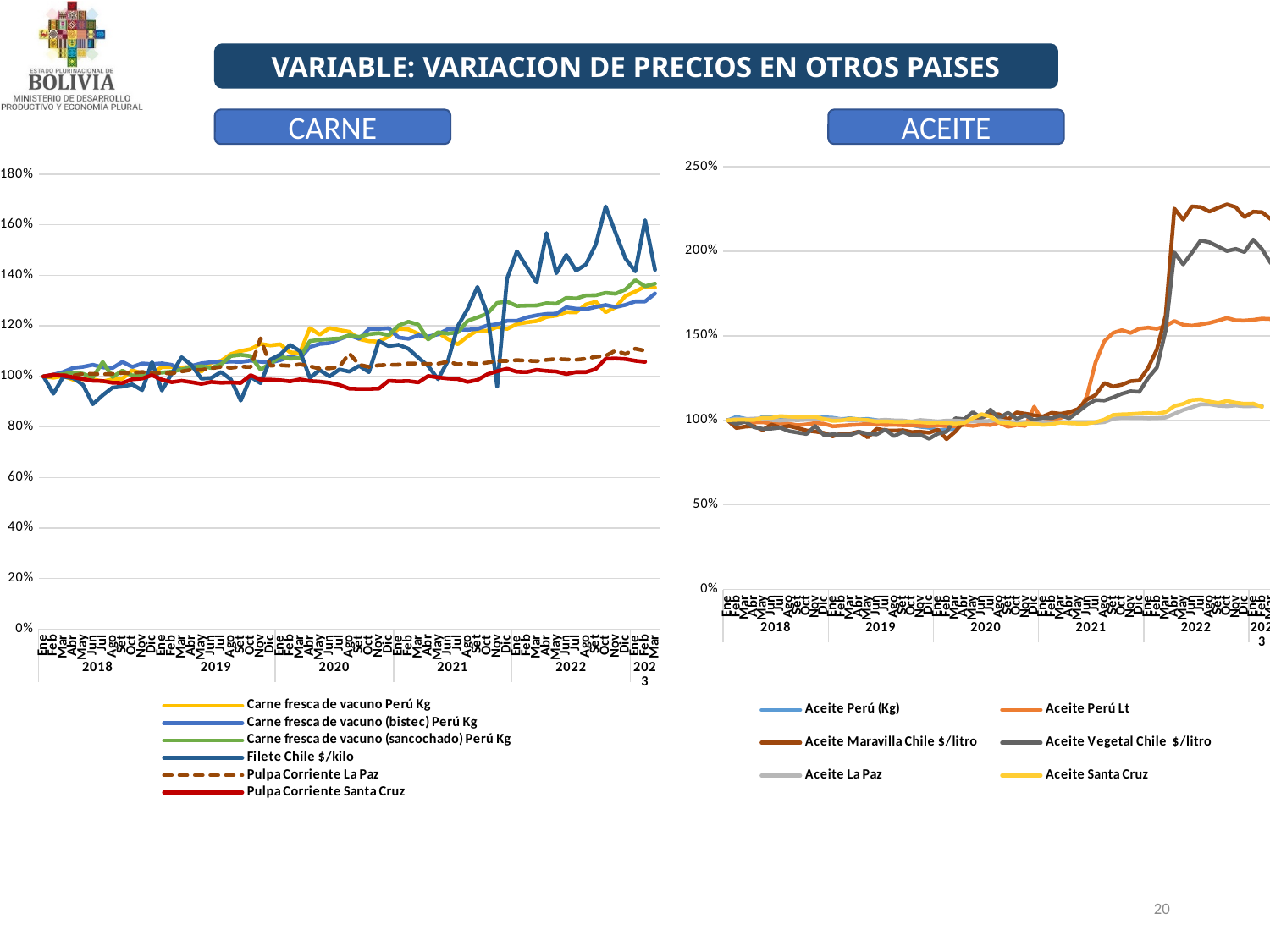
In the ACEITE chart, is the value for Aceite La Paz at the end of the period greater or less than 150%? less What kind of chart is the ACEITE chart? line chart In the ACEITE chart, which series reaches the highest value over the whole period? Aceite Maravilla Chile $/litro In the ACEITE chart, does the Aceite Maravilla Chile $/litro series generally rise or fall from 2018 to 2023? rise In the CARNE chart, at the end of the period, which is higher: Filete Chile $/kilo or Pulpa Corriente Santa Cruz? Filete Chile $/kilo What kind of chart is the CARNE chart? line chart In the CARNE chart, which series reaches the highest value over the whole period? Filete Chile $/kilo In the CARNE chart, is the peak value for Filete Chile $/kilo greater or less than 150%? greater How many series does the legend of the CARNE chart list? 6 In the ACEITE chart, is the peak value for Aceite Maravilla Chile $/litro greater or less than 200%? greater How many series does the legend of the ACEITE chart list? 6 In the ACEITE chart, at the end of the period, which is higher: Aceite Maravilla Chile $/litro or Aceite Vegetal Chile $/litro? Aceite Maravilla Chile $/litro